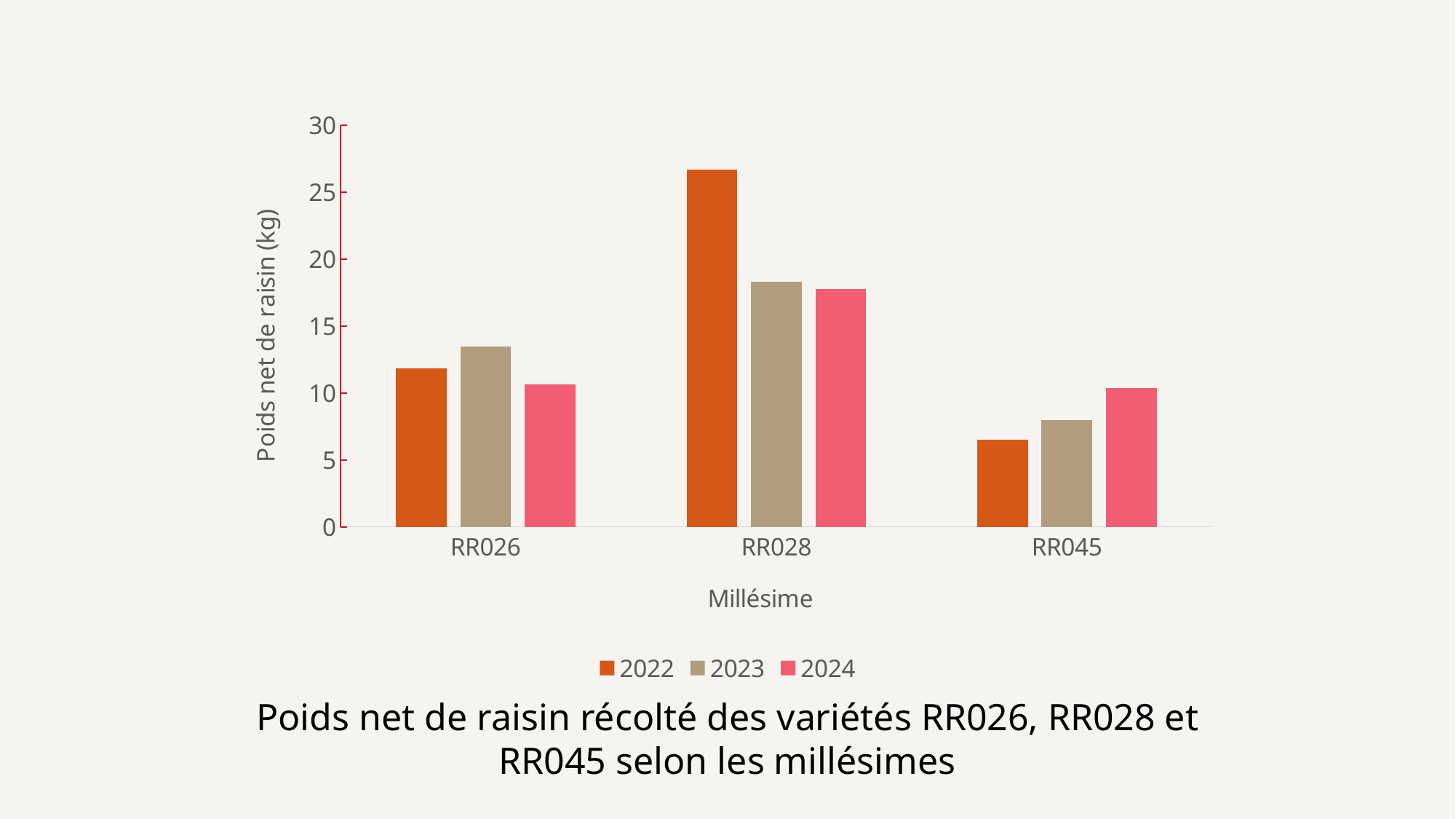
Is the 2023 value for RR028 greater or less than 20? less How many series does the legend list? 3 What is the label of the y axis? Poids net de raisin (kg) Is the 2022 value for RR028 greater or less than 25? greater For RR026, which is larger: the 2023 value or the 2024 value? 2023 Is the 2023 value for RR026 greater or less than 15? less For RR045, do the values rise or fall from 2022 to 2024? rise How many varieties (categories) are shown on the x axis? 3 What kind of chart is shown on the slide? bar chart Which variety has the highest bar for 2022? RR028 Which variety has the lowest bar for 2022? RR045